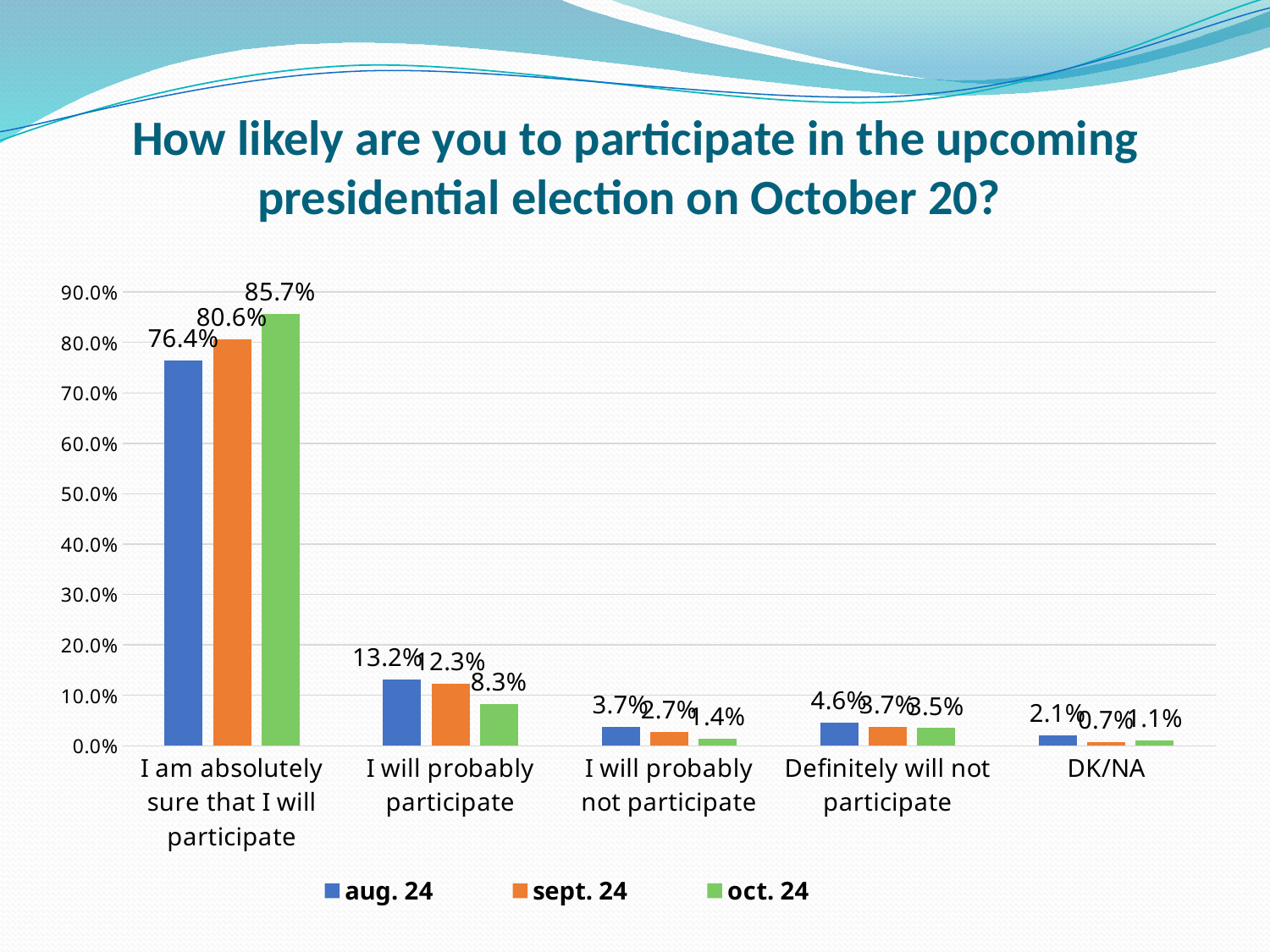
For "I will probably participate", which series has the larger value: aug. 24 or oct. 24? aug. 24 How many categories are shown on the x axis? 5 Across the three series, do the values for "I am absolutely sure that I will participate" rise or fall from aug. 24 to oct. 24? Rise What is the value for "I will probably participate" in the aug. 24 series? 13.2% What is the value for "I will probably participate" in the oct. 24 series? 8.3% How many series does the legend list? 3 What kind of chart is shown on the slide? Bar chart Which category has the highest value in the aug. 24 series? I am absolutely sure that I will participate What is the value for "I am absolutely sure that I will participate" in the oct. 24 series? 85.7% What is the difference between the oct. 24 and aug. 24 values for "I am absolutely sure that I will participate"? 9.3% Which category has the lowest value in the sept. 24 series? DK/NA What is the value for "I am absolutely sure that I will participate" in the sept. 24 series? 80.6%